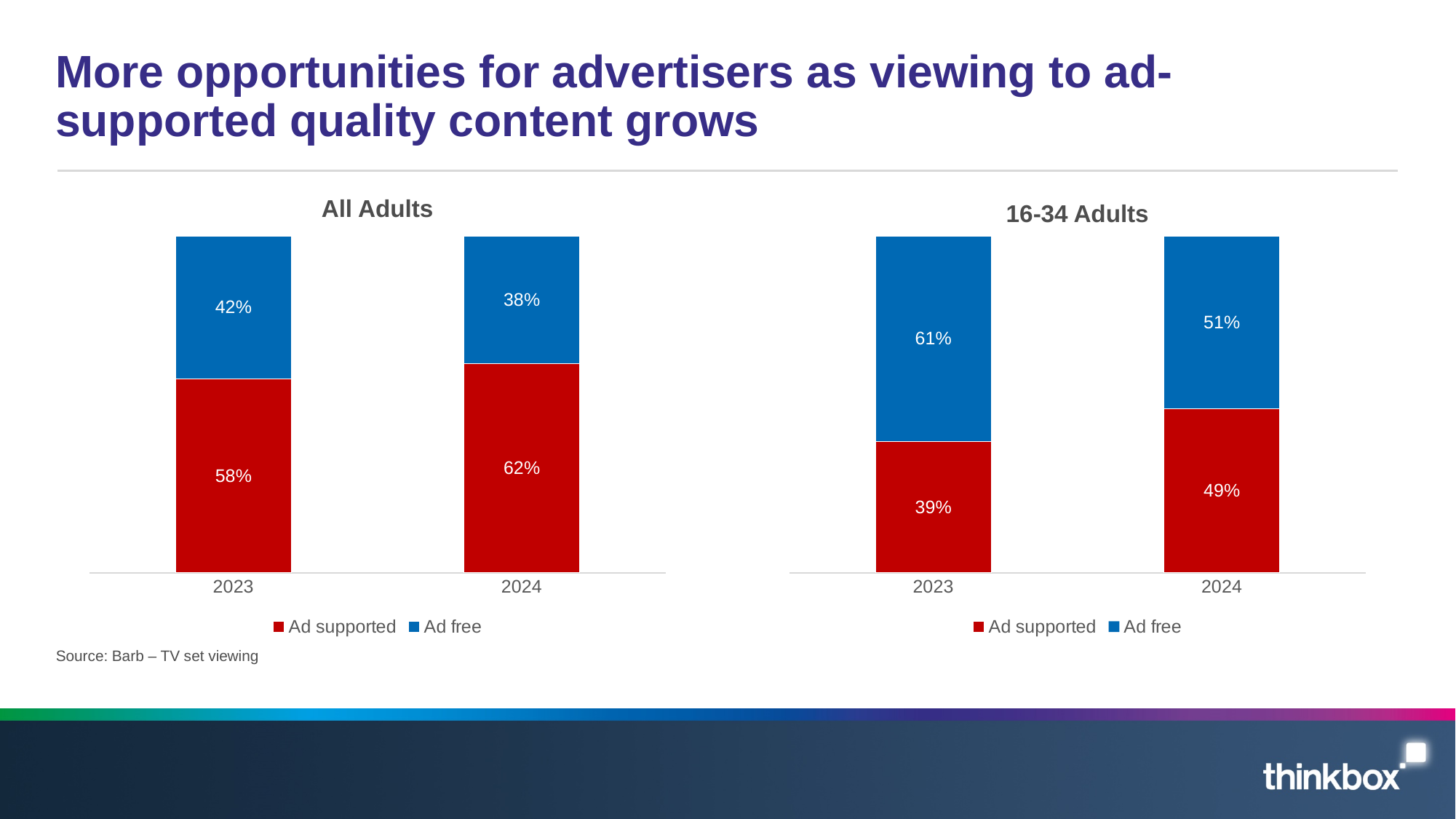
In the 16-34 Adults chart, by how many percentage points did the Ad supported share rise from 2023 to 2024? 10 percentage points In the All Adults chart, what is the Ad free value for 2024? 38% In the 16-34 Adults chart, which is larger in 2023: Ad supported or Ad free? Ad free In the All Adults chart, which colour represents Ad free? Blue How many series does the legend of the All Adults chart list? 2 In the All Adults chart, what is the difference between the Ad supported and Ad free values in 2024? 24 percentage points In the All Adults chart, does the Ad supported share rise or fall from 2023 to 2024? Rise In the 16-34 Adults chart, what is the Ad supported value for 2023? 39% In the 16-34 Adults chart, what is the Ad free value for 2024? 51% In the 16-34 Adults chart, what is the total of the stacked bar for 2024? 100% What type of chart is the 16-34 Adults chart? Stacked bar chart In the All Adults chart, what is the Ad supported value for 2023? 58%